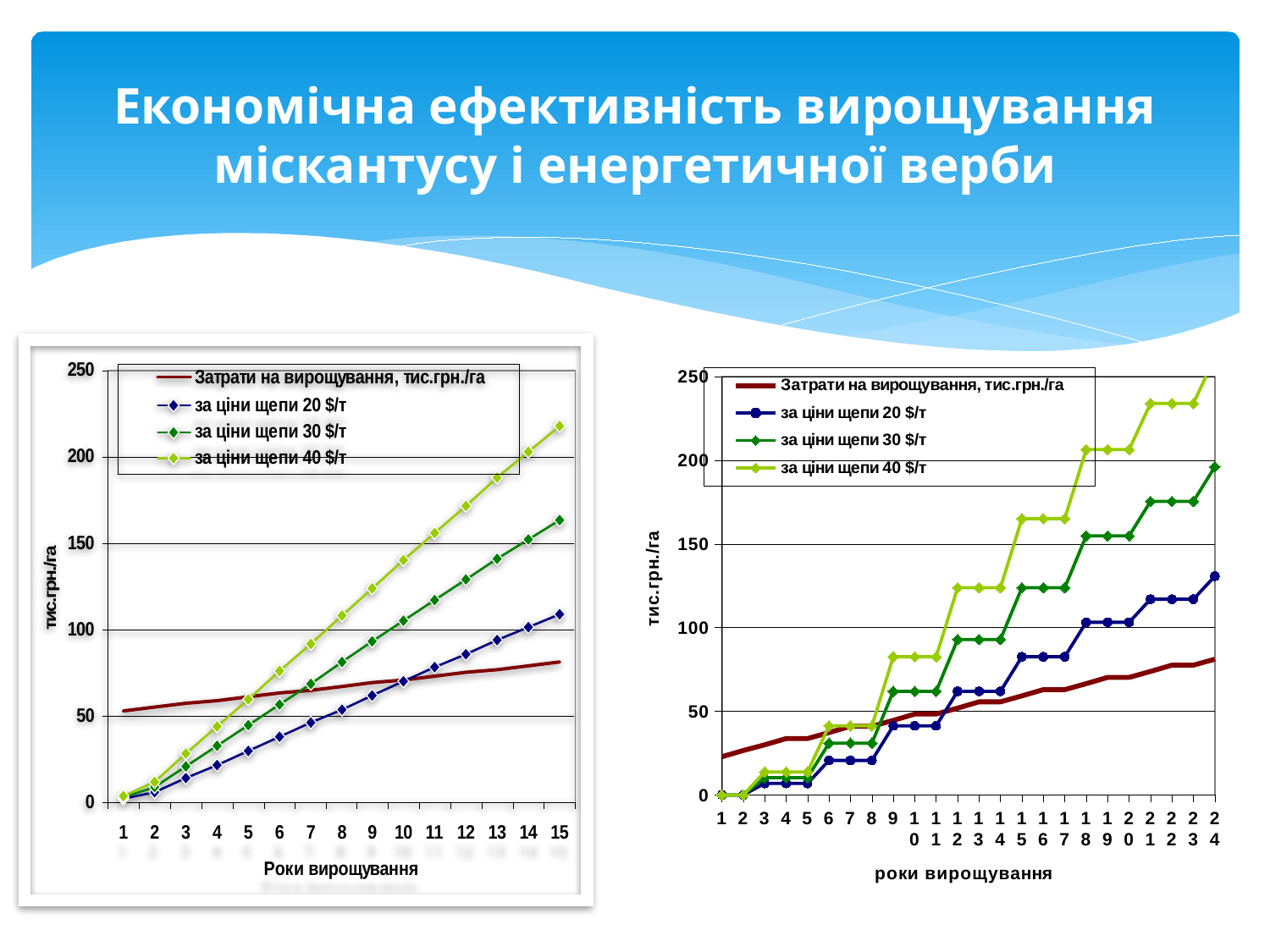
In the left chart, is the value for 'Затрати на вирощування' at year 15 greater or less than 100? less In the left chart, is the value for 'за ціни щепи 40 $/т' at year 15 greater or less than 200? greater How many years are shown on the x axis of the left chart? 15 In the left chart, which series has the highest value at year 15? за ціни щепи 40 $/т What kind of chart is the left chart on the slide? line chart How many years are shown on the x axis of the right chart? 24 How many series does the legend of the right chart list? 4 In the right chart, is the value for 'за ціни щепи 20 $/т' at year 24 greater or less than 100? greater In the right chart, do the values for 'за ціни щепи 40 $/т' rise or fall from year 1 to year 24? rise In the left chart, at year 15, which is larger: the value for 'за ціни щепи 30 $/т' or for 'за ціни щепи 20 $/т'? за ціни щепи 30 $/т What is the y-axis label of the left chart? тис.грн./га